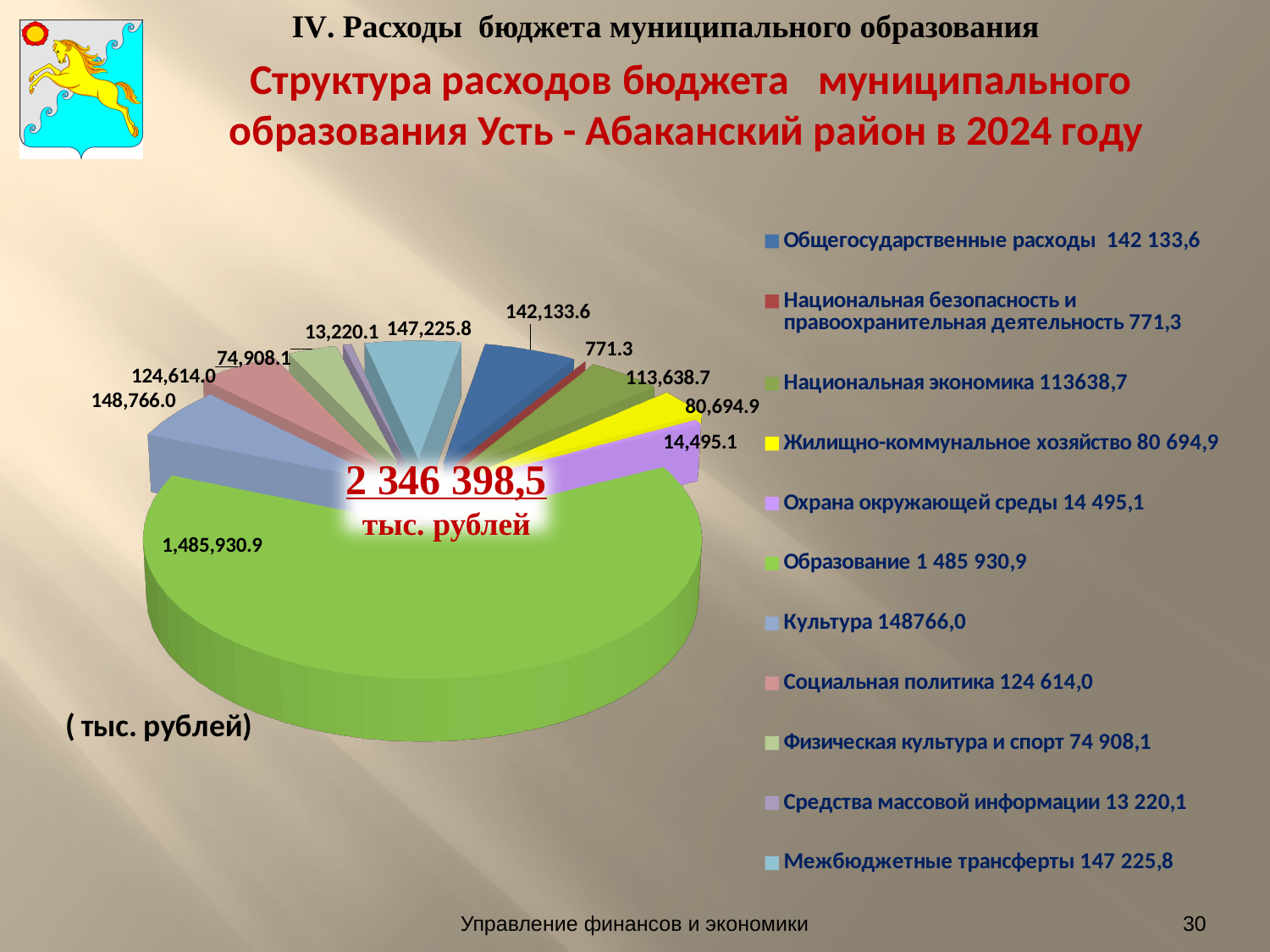
What colour is the Образование slice in the pie chart? green Which is larger: Национальная экономика or Жилищно-коммунальное хозяйство? Национальная экономика Which category has the smallest slice in the pie chart? Национальная безопасность и правоохранительная деятельность What is the value for Национальная безопасность и правоохранительная деятельность? 771.3 Which category has the largest slice in the pie chart? Образование What kind of chart is shown on the slide? pie chart What is the value for Культура in the pie chart? 148,766.0 What is the difference between Общегосударственные расходы (142,133.6) and Социальная политика (124,614.0)? 17,519.6 What is the value for Образование in the pie chart? 1,485,930.9 What is the value for Жилищно-коммунальное хозяйство? 80,694.9 What total amount is printed in the centre of the pie chart? 2 346 398,5 тыс. рублей How many categories (slices) does the pie chart have? 11